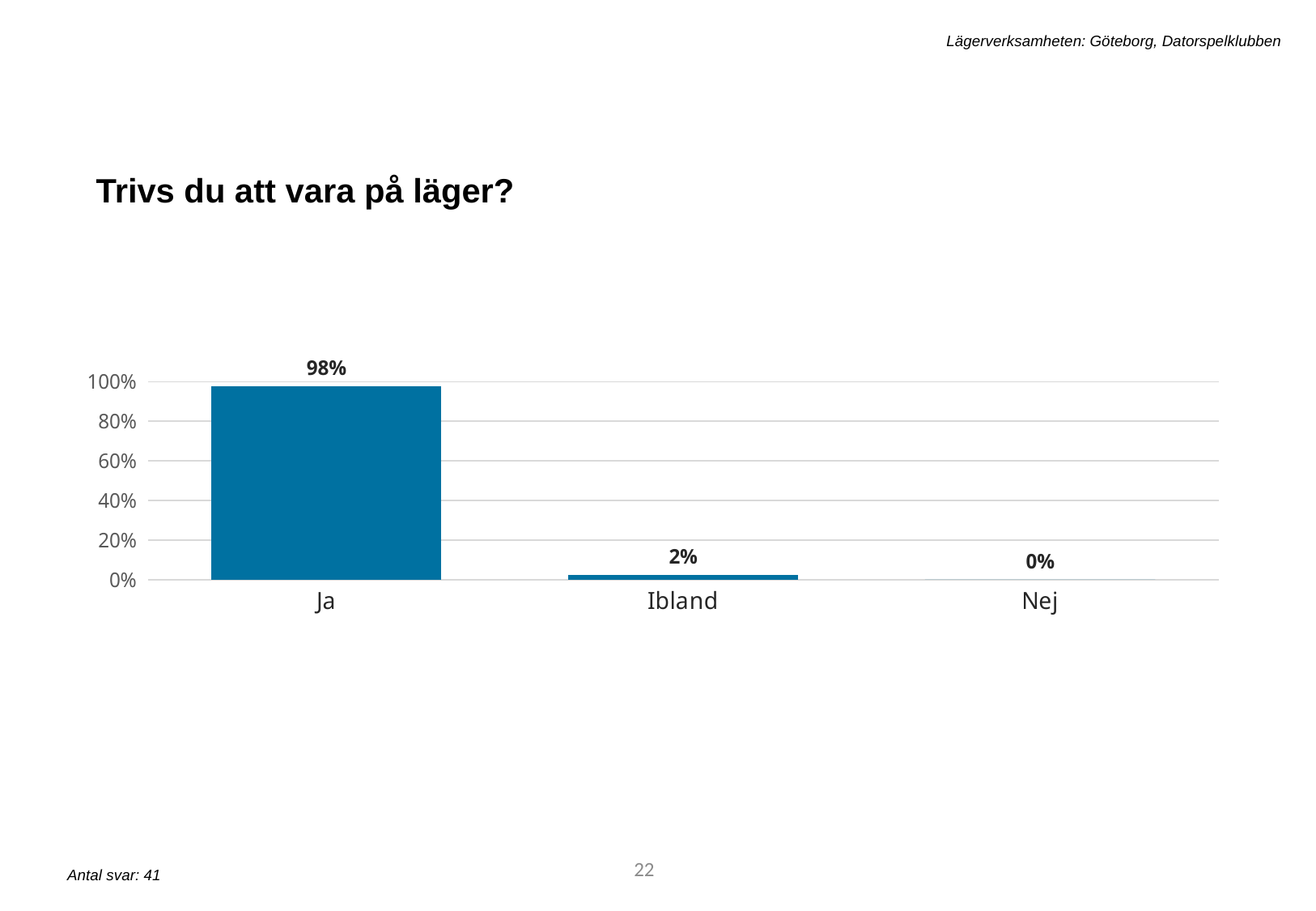
Which category has the highest value? Ja What kind of chart is shown on the slide? bar chart What is the value for Ibland? 2% What is the value for Ja? 98% What is the difference between the values for Ja and Ibland? 96% Which category has the lowest value? Nej What is the value for Nej? 0% What is the title of the chart? Trivs du att vara på läger? Which is larger, the value for Ibland or the value for Nej? Ibland Is the value for Ja greater or less than 80%? greater How many categories are shown on the x axis? 3 Do the values rise or fall from left to right along the x axis? fall